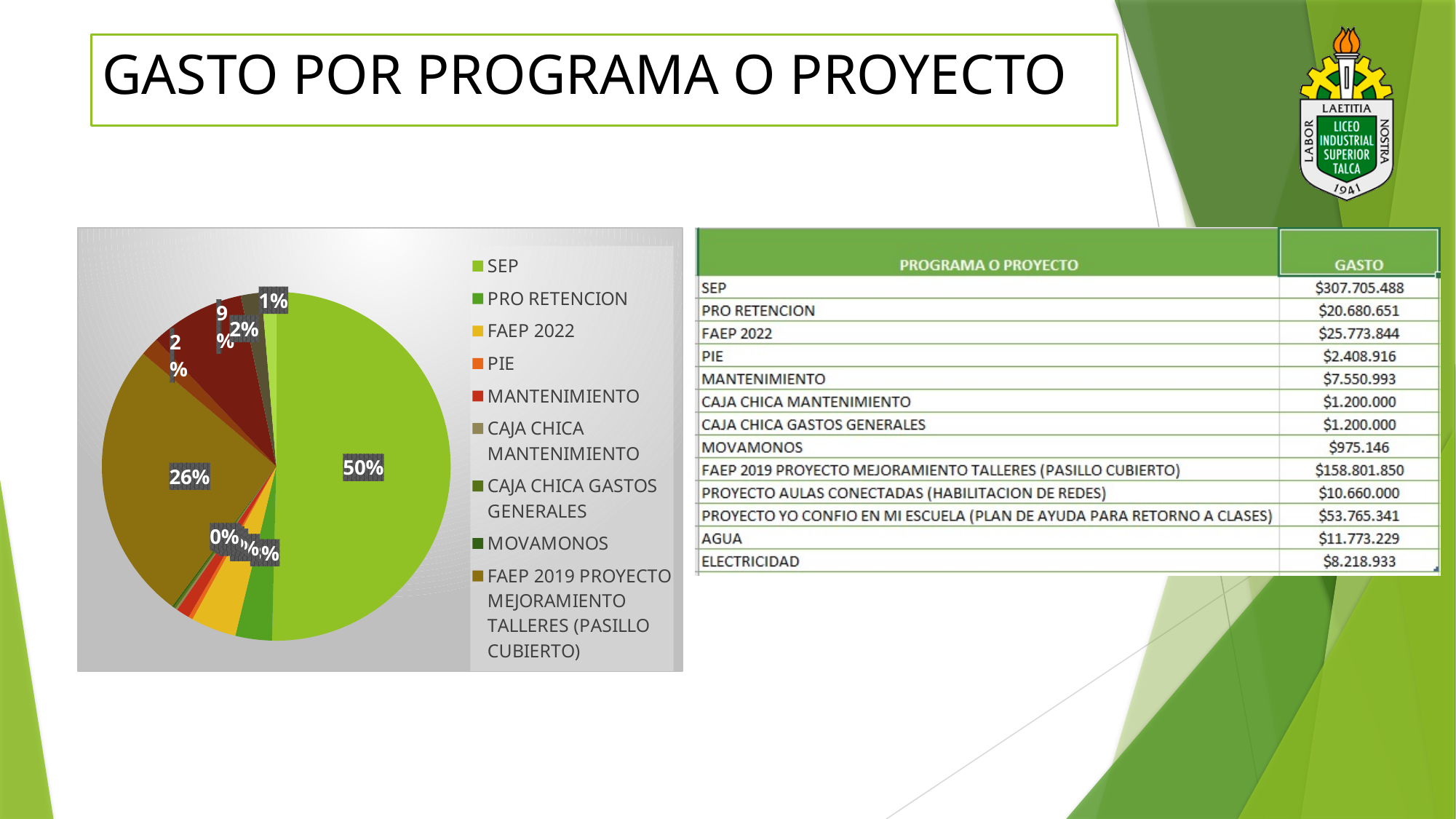
How many legend entries are visible next to the pie chart? 9 Which is larger in the pie chart, the SEP slice or the FAEP 2019 PROYECTO MEJORAMIENTO TALLERES slice? SEP Which program has the largest slice in the pie chart? SEP What colour is the SEP slice in the pie chart? green What share of the pie chart is labelled 26%? FAEP 2019 PROYECTO MEJORAMIENTO TALLERES (PASILLO CUBIERTO) What percentage of the pie chart does SEP account for? 50% What is the difference in percentage points between the SEP slice (50%) and the 26% slice? 24% Is the share for SEP in the pie chart greater or less than 40%? greater What kind of chart is shown on the slide? pie chart What is the first entry listed in the pie chart legend? SEP